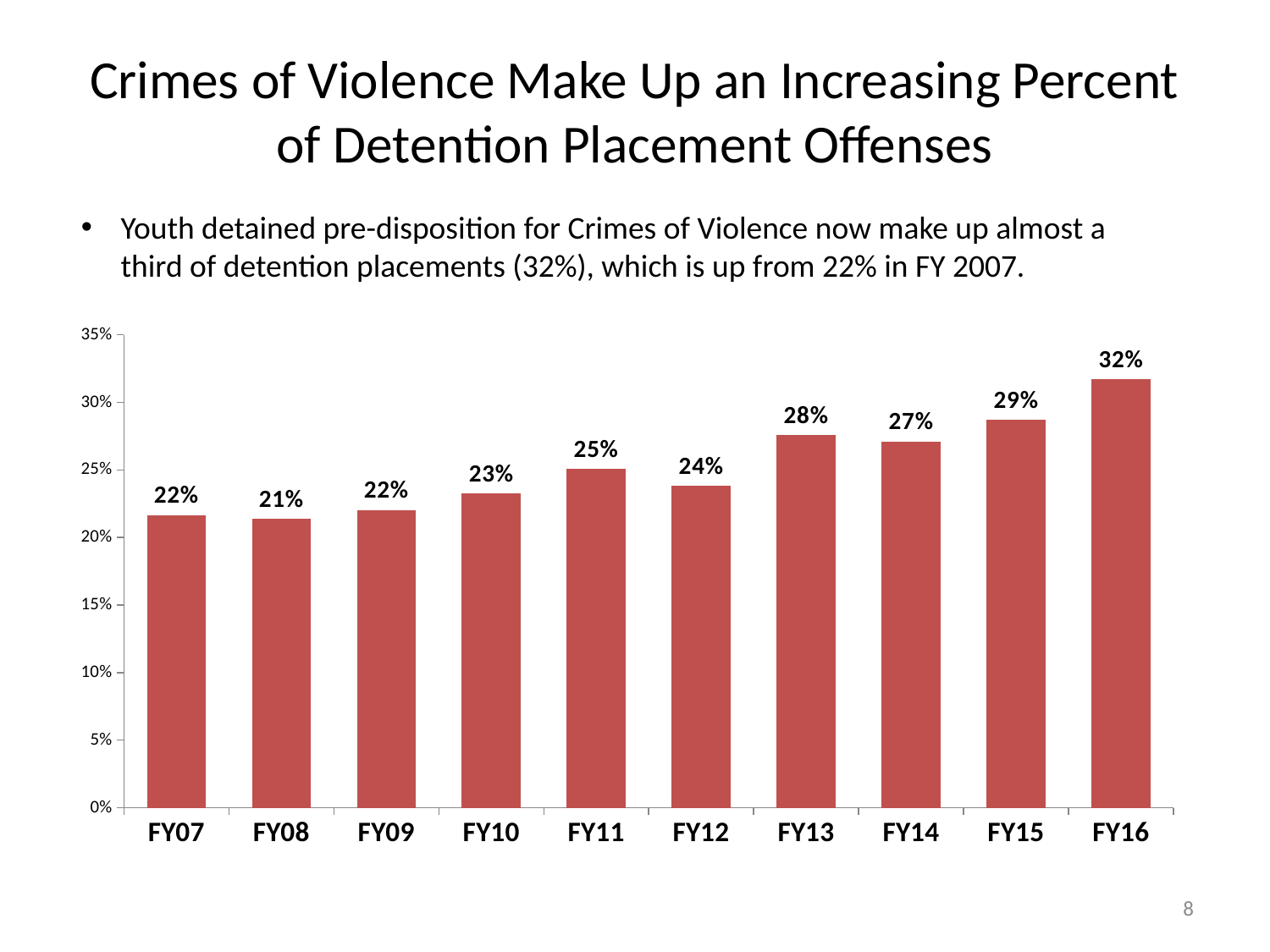
What is the value for FY16? 32% Which is larger, the value for FY14 or the value for FY15? FY15 Which fiscal year has the highest value? FY16 What is the difference between the values for FY16 and FY07? 10% Which fiscal year has the lowest value? FY08 What kind of chart is shown on the slide? bar chart What is the value for FY07? 22% How many fiscal years are shown on the x axis? 10 Do the values generally rise or fall from FY07 to FY16? rise What is the highest value shown on the y axis? 35% What is the value for FY13? 28% Is the value for FY16 greater or less than 30%? greater